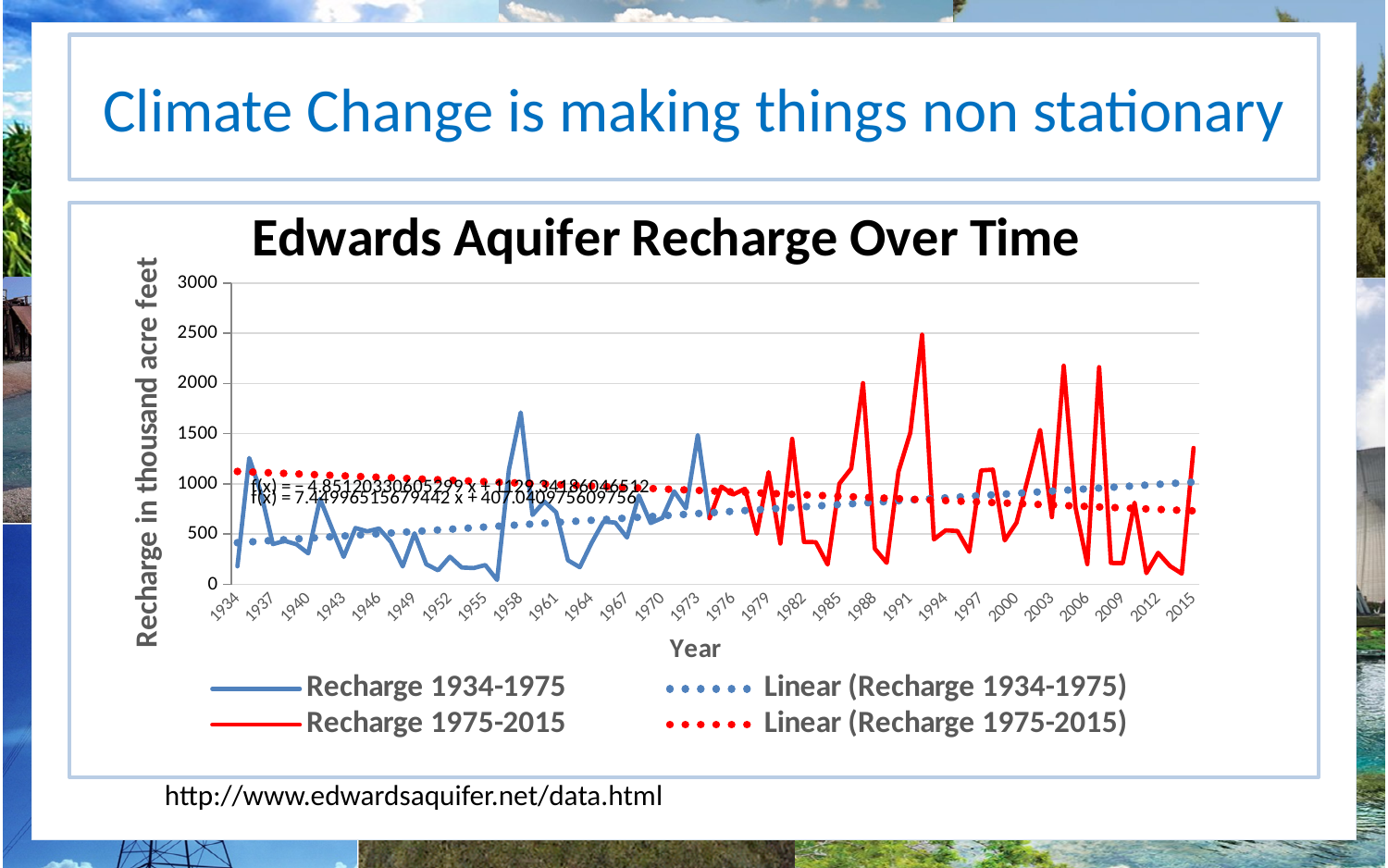
What is the label of the vertical axis? Recharge in thousand acre feet Is the recharge value around 1956 greater or less than 500? less Is the recharge value for 1934 greater or less than 500? less Which series reaches the highest peak value on the chart, Recharge 1934-1975 or Recharge 1975-2015? Recharge 1975-2015 What is the highest value shown on the vertical axis? 3000 What kind of chart is shown on the slide? line chart How many entries does the chart legend list? 4 What is the title of the chart? Edwards Aquifer Recharge Over Time Does the dotted trend line for Recharge 1975-2015 rise or fall from left to right? fall Is the peak recharge value around 1958 greater or less than 1500? greater Does the dotted trend line for Recharge 1934-1975 rise or fall from left to right? rise